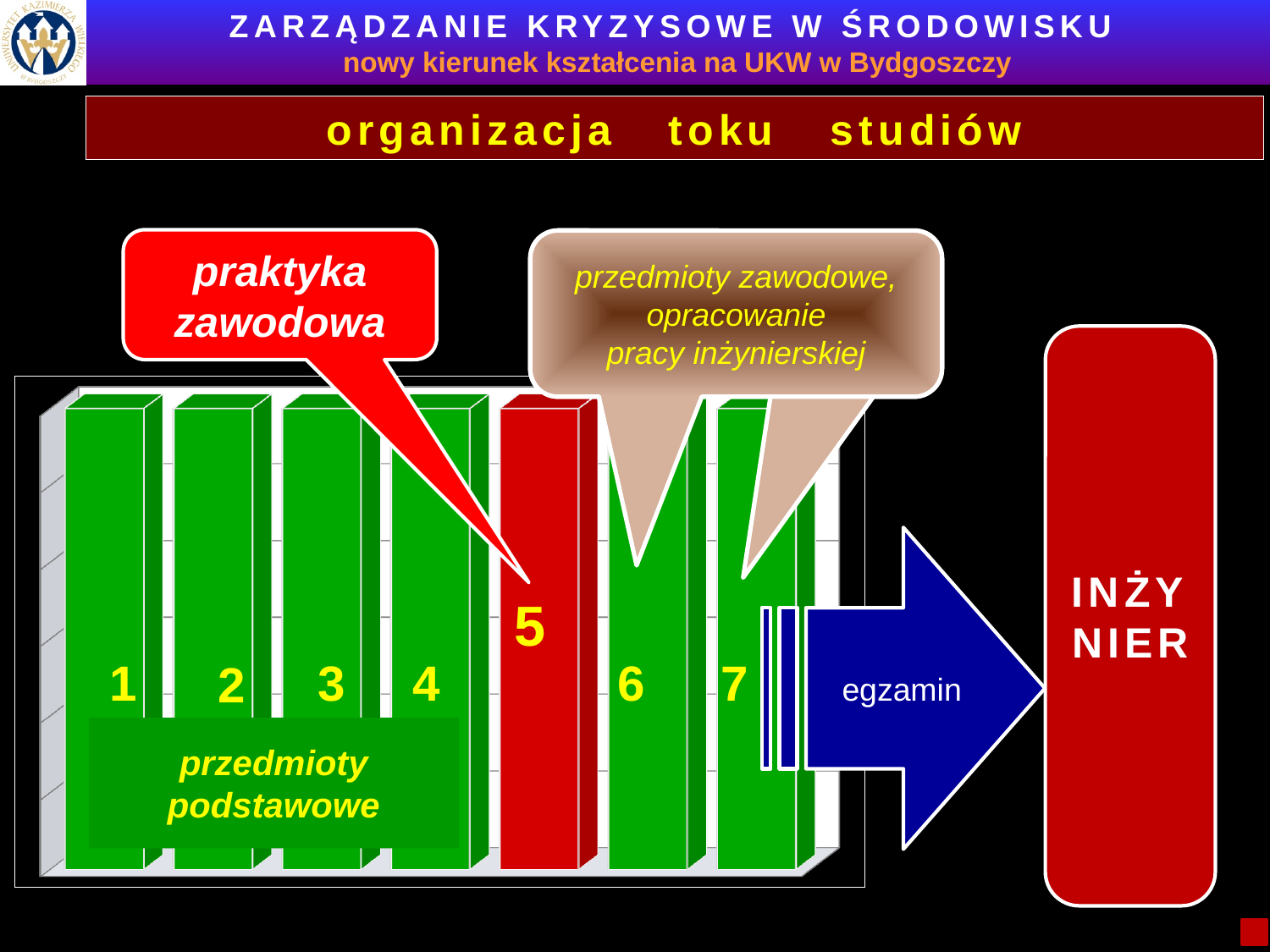
Do the bar heights rise, fall, or stay the same from bar 1 to bar 7? stay the same How many of the bars in the chart are red? 1 Which numbered bar is coloured red instead of green? 5 What label does the red callout attached to bar 5 show? praktyka zawodowa What kind of chart is shown on the slide? bar chart How many numbered bars does the chart contain? 7